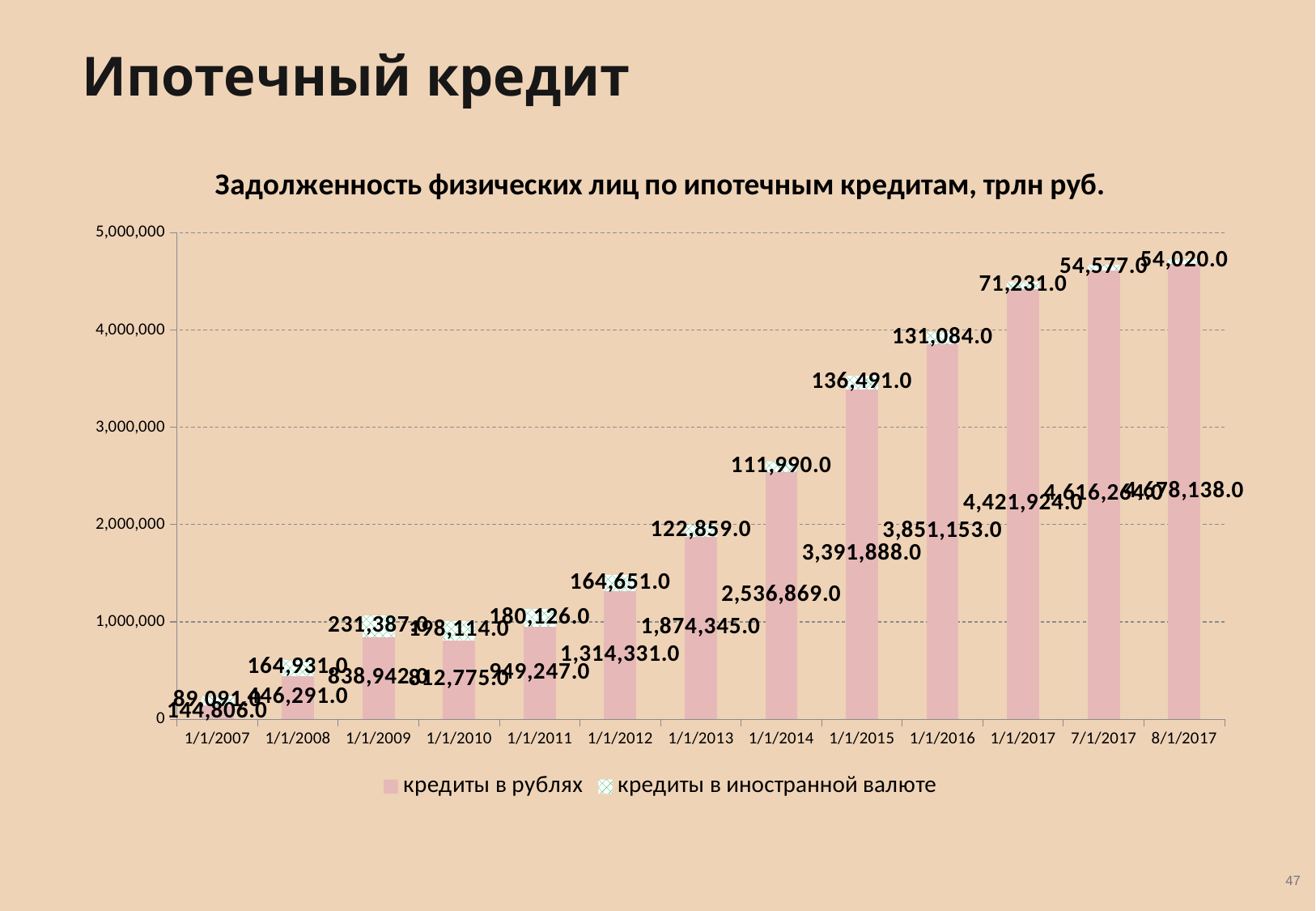
On which date is the value for кредиты в иностранной валюте highest? 1/1/2009 What is the difference between the кредиты в рублях values on 1/1/2014 and 1/1/2013? 662,524.0 On which date is the value for кредиты в рублях lowest? 1/1/2007 What kind of chart is shown on the slide? Stacked bar chart Which is larger, the кредиты в иностранной валюте value on 1/1/2010 or on 1/1/2011? 1/1/2010 Is the value for кредиты в рублях on 1/1/2016 greater or less than 3,000,000? greater What is the value for кредиты в рублях on 1/1/2015? 3,391,888.0 How many series does the legend list? 2 How many dates are shown on the x axis? 13 What is the value for кредиты в иностранной валюте on 1/1/2012? 164,651.0 What is the value for кредиты в рублях on 1/1/2007? 144,806.0 What is the total of the stacked bar for 1/1/2015? 3,528,379.0